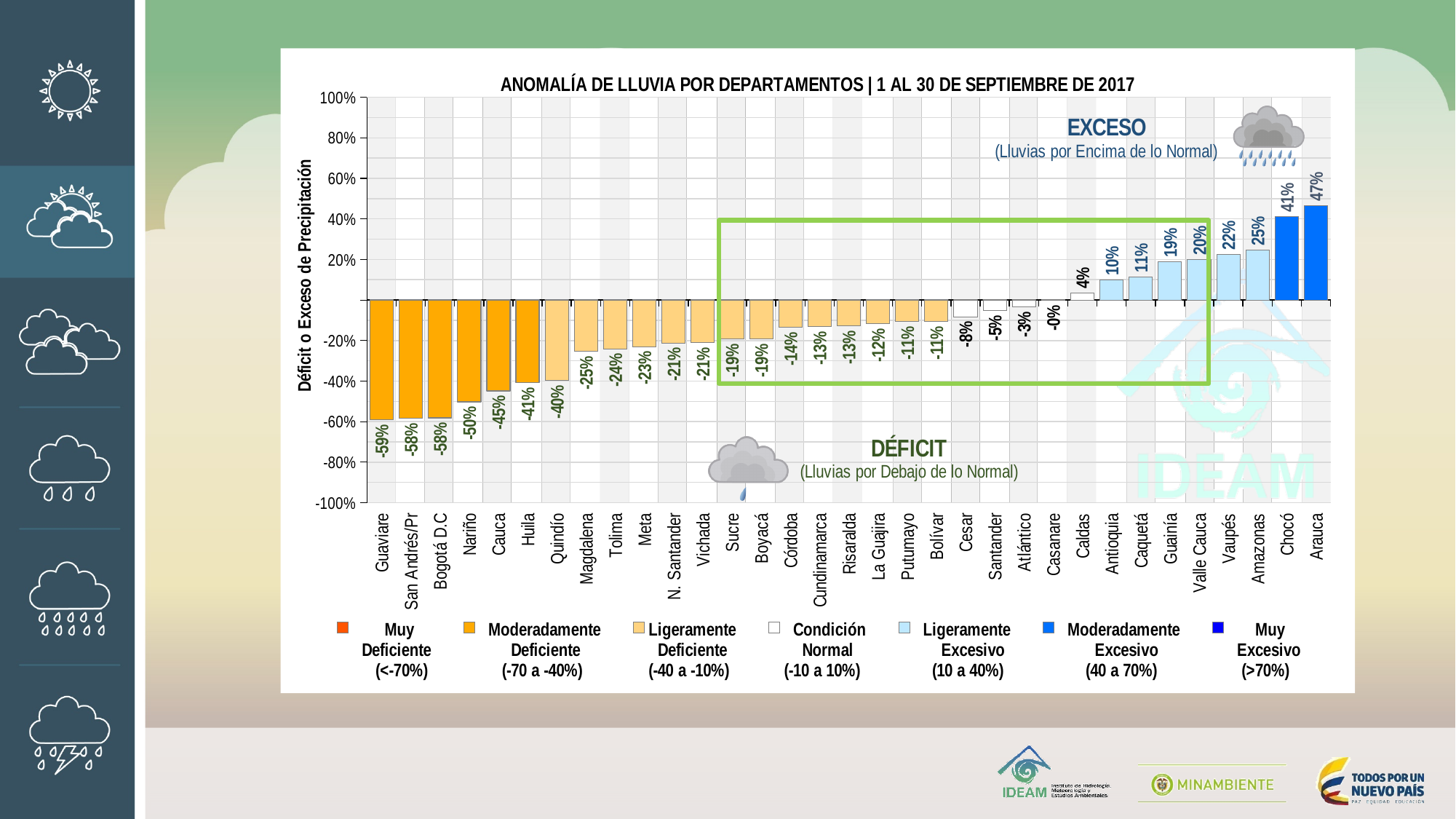
What is the rainfall anomaly value shown for Nariño? -50% What is the rainfall anomaly value shown for Arauca? 47% What kind of chart is shown on the slide? Bar chart How many categories does the legend below the chart list? 7 What is the rainfall anomaly value shown for Valle Cauca? 20% What is the difference between the values for Arauca and Chocó? 6% Which department has the lowest rainfall anomaly value? Guaviare How many departments are shown on the x axis of the chart? 33 Which department has the highest rainfall anomaly value? Arauca What is the rainfall anomaly value shown for Guaviare? -59% What is the title of the chart? ANOMALÍA DE LLUVIA POR DEPARTAMENTOS | 1 AL 30 DE SEPTIEMBRE DE 2017 Which has a larger rainfall anomaly value, Amazonas or Vaupés? Amazonas